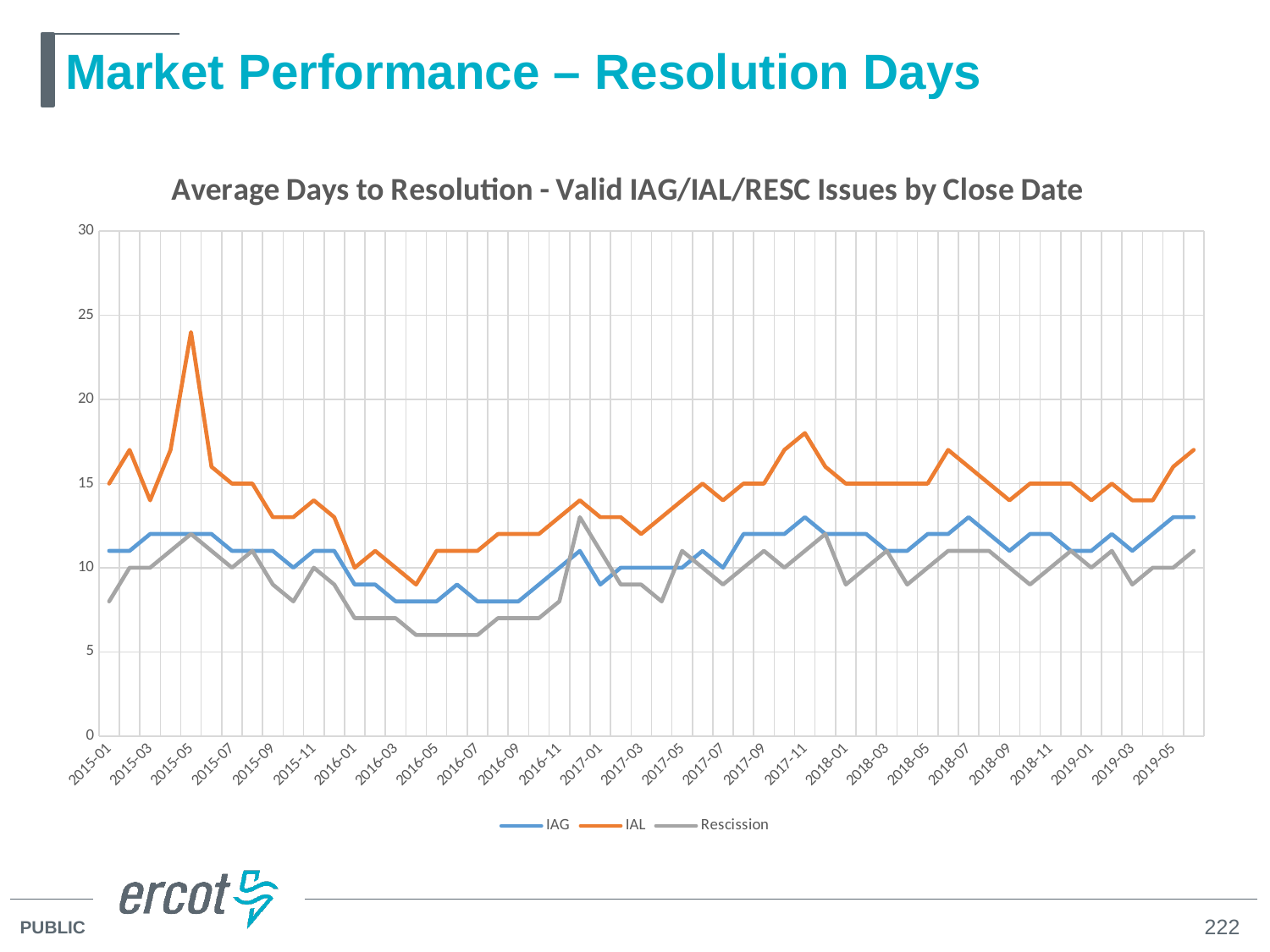
Which series has the highest value at 2015-05? IAL Is the IAG value at 2019-05 greater or less than 15? less Which series has the lowest value at 2016-05? Rescission What is the IAL value at 2015-01? 15 Is the Rescission value at 2016-05 greater or less than 10? less Is the IAL value at 2015-05 greater or less than 20? greater What is the title of the chart? Average Days to Resolution - Valid IAG/IAL/RESC Issues by Close Date Which series are listed in the legend? IAG, IAL, Rescission What kind of chart is shown on the slide? line chart How many series does the legend list? 3 At 2017-11, which is larger, the IAL value or the IAG value? IAL